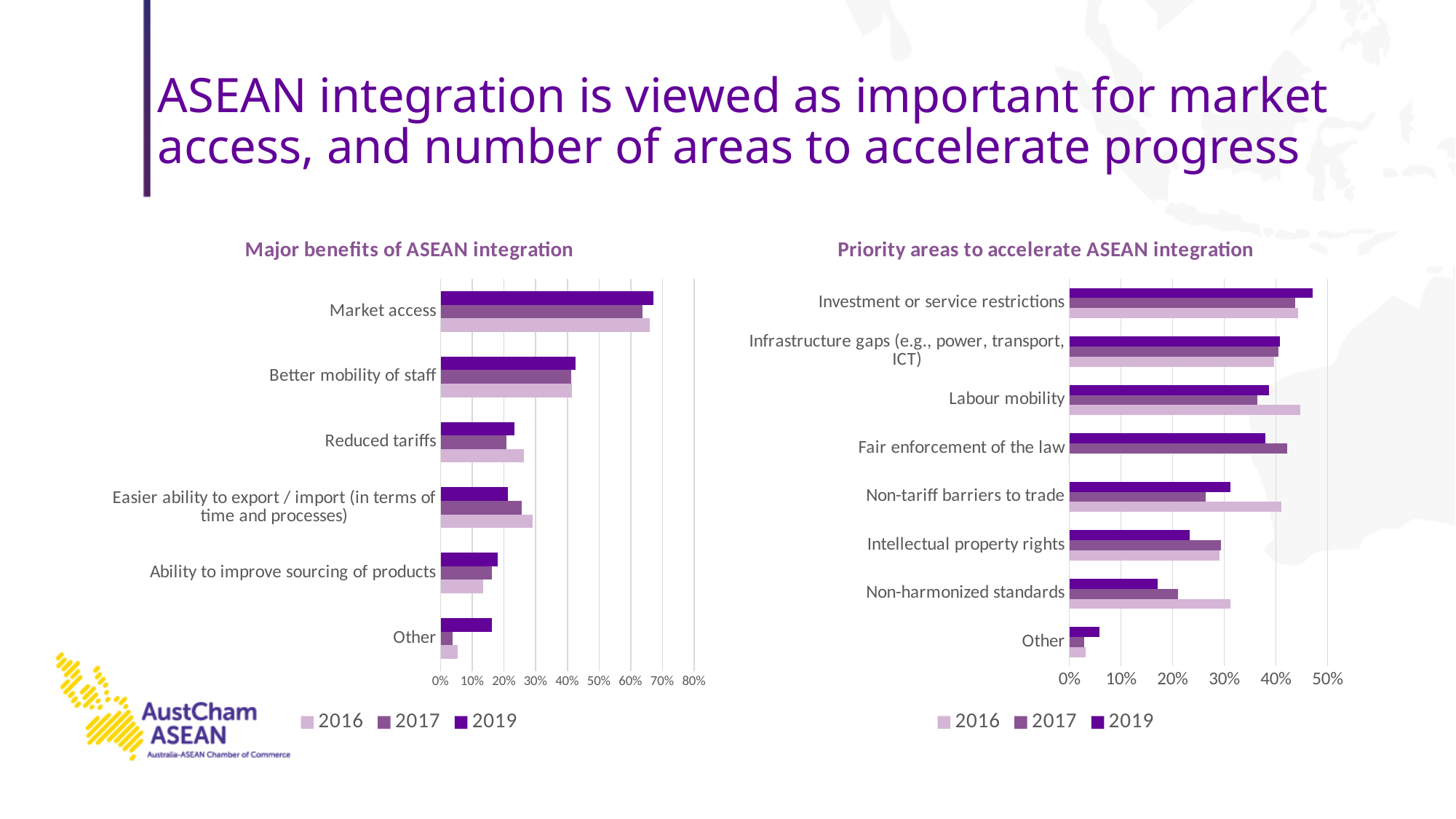
In the 'Major benefits of ASEAN integration' chart, how many categories are shown? 6 In the 'Priority areas to accelerate ASEAN integration' chart, which is larger for Non-tariff barriers to trade: the 2016 value or the 2017 value? 2016 How many series does the legend of the 'Priority areas to accelerate ASEAN integration' chart list? 3 In the 'Priority areas to accelerate ASEAN integration' chart, is the 2016 value for Labour mobility greater or less than 40%? greater In the 'Major benefits of ASEAN integration' chart, which is larger for Other: the 2017 value or the 2019 value? 2019 In the 'Priority areas to accelerate ASEAN integration' chart, is the 2019 value for Non-harmonized standards greater or less than 20%? less In the 'Priority areas to accelerate ASEAN integration' chart, which category has the highest value for 2019? Investment or service restrictions In the 'Major benefits of ASEAN integration' chart, is the 2019 value for Market access greater or less than 60%? greater In the 'Major benefits of ASEAN integration' chart, which category has the lowest value for 2017? Other In the 'Major benefits of ASEAN integration' chart, which category has the highest value for 2019? Market access In the 'Priority areas to accelerate ASEAN integration' chart, how many categories are shown? 8